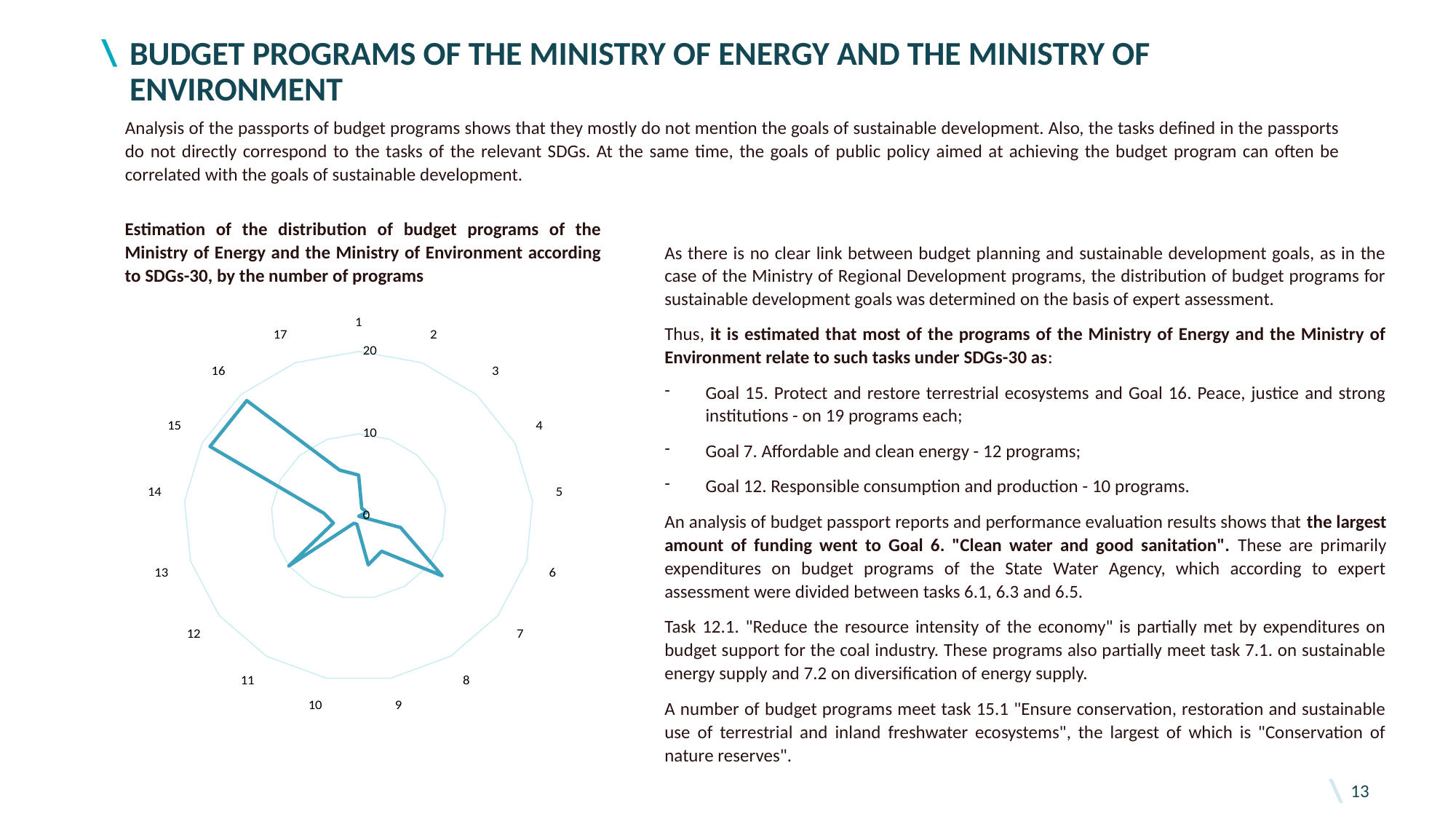
Is the value for goal 16 greater or less than 10? greater Which has the larger value, goal 15 or goal 7? Goal 15 According to the chart's title, what does the chart measure the distribution of budget programs by? The number of programs Is the value for goal 11 greater or less than 10? less Which has the larger value, goal 7 or goal 10? Goal 7 Is the value for goal 1 greater or less than 10? less Which has the larger value, goal 16 or goal 3? Goal 16 How many categories (goals) are plotted around the radar chart? 17 What kind of chart is shown on the slide? Radar chart What is the highest tick value shown on the radar chart's axis? 20